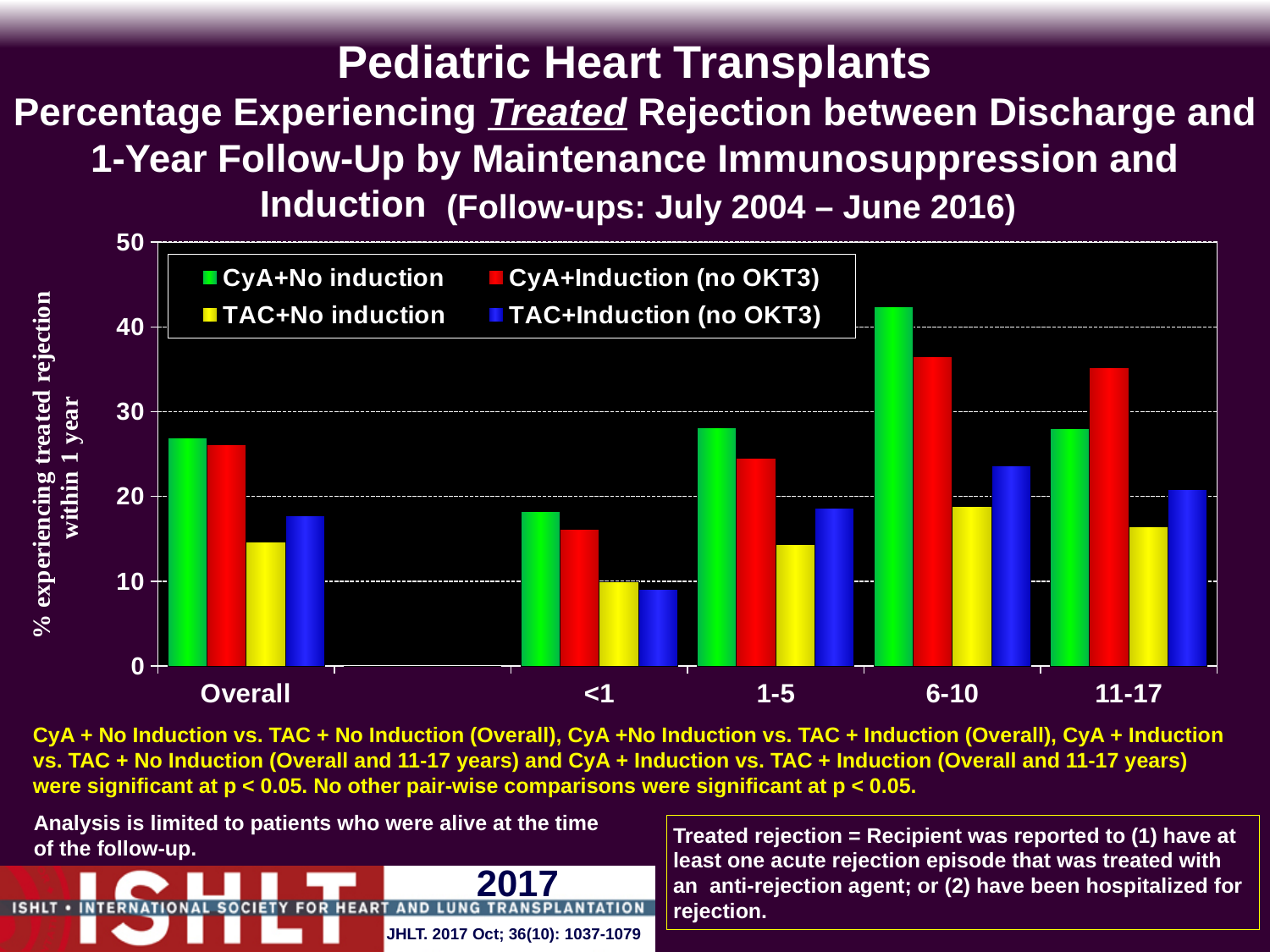
What kind of chart is shown on the slide? Bar chart In the 6-10 category, which is larger: TAC+No induction or TAC+Induction (no OKT3)? TAC+Induction (no OKT3) Is the value for TAC+No induction in the Overall category greater or less than 20? less How many age-group categories are shown along the x axis of the chart? 5 Which category has the lowest value for TAC+Induction (no OKT3)? <1 Which category has the highest value for CyA+No induction? 6-10 What is the label on the y axis of the chart? % experiencing treated rejection within 1 year What colour represents TAC+No induction in the chart legend? Yellow Is the value for CyA+No induction in the 6-10 category greater or less than 40? greater How many series does the chart legend list? 4 Is the value for CyA+Induction (no OKT3) in the 11-17 category greater or less than 30? greater In the 11-17 category, which is larger: CyA+No induction or CyA+Induction (no OKT3)? CyA+Induction (no OKT3)